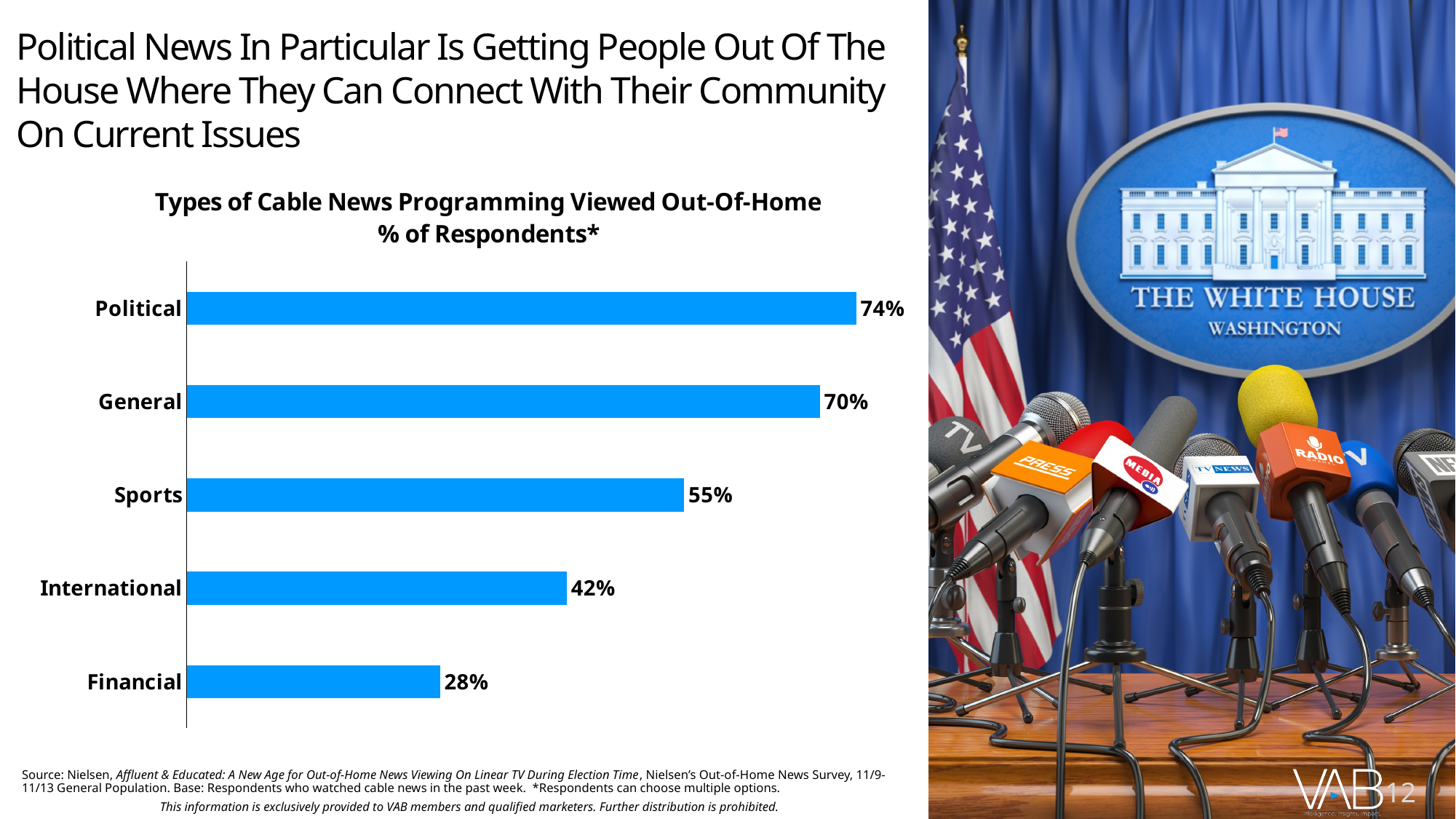
What percentage of respondents viewed Political cable news programming out-of-home? 74% What is the value shown for Sports? 55% Which has a higher value, Sports or International? Sports What colour are the bars in the chart? Blue What is the difference in percentage points between International and Financial? 14 What is the title of the chart? Types of Cable News Programming Viewed Out-Of-Home % of Respondents* What is the difference in percentage points between Political and General? 4 Which type of cable news programming has the lowest percentage of respondents? Financial How many types of cable news programming are shown in the chart? 5 What percentage of respondents viewed Financial cable news programming out-of-home? 28% What kind of chart is used on this slide? Bar chart Which type of cable news programming has the highest percentage of respondents? Political